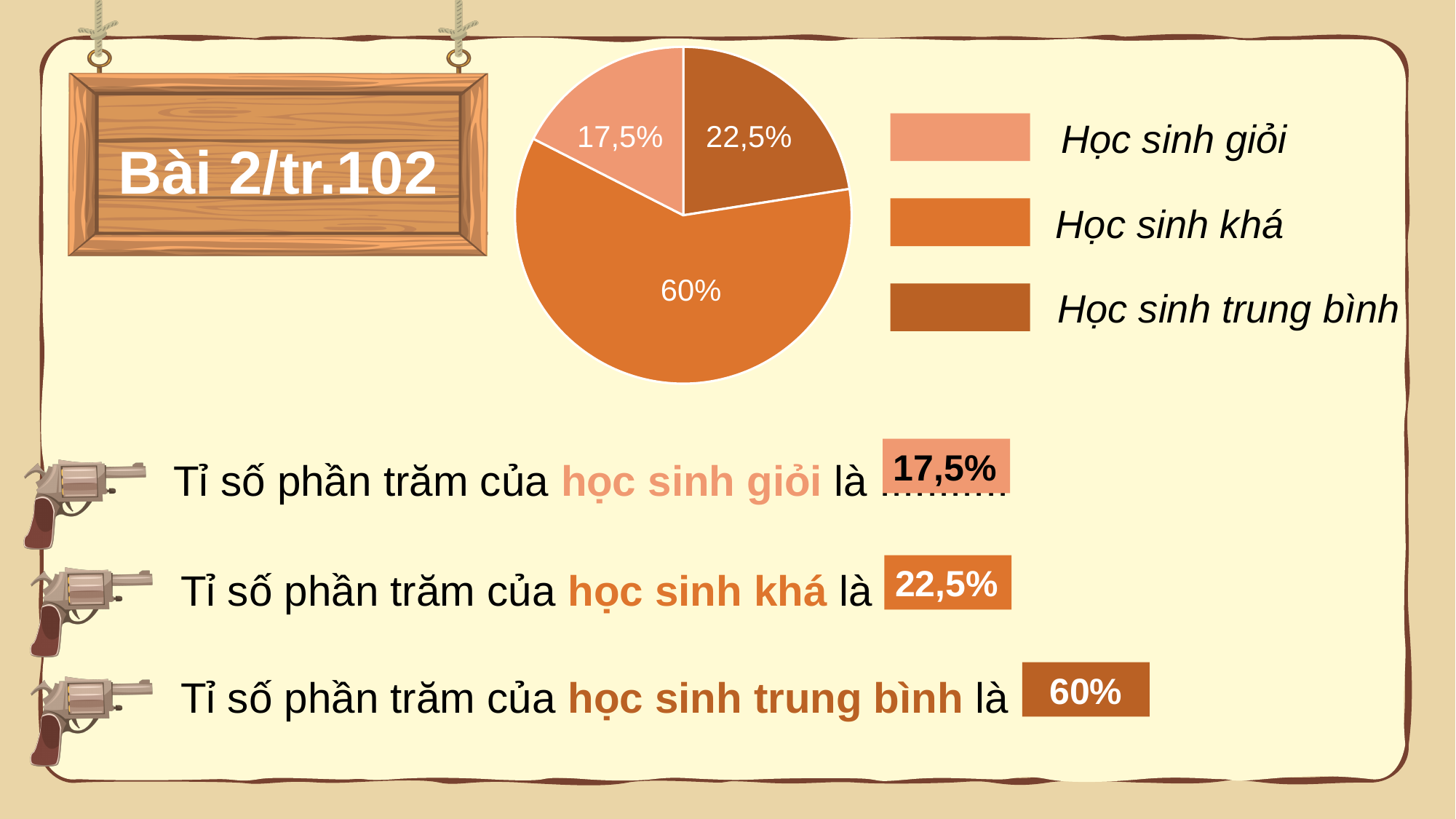
What percentage is shown for Học sinh giỏi in the pie chart? 17,5% What value is printed on the orange slice of the pie chart? 60% Which legend entry is shown with the lightest (salmon) colour in the pie chart? Học sinh giỏi What value is printed on the smallest slice of the pie chart? 17,5% How many entries does the legend of the pie chart list? 3 What is the difference between the 22,5% slice and the 17,5% slice in the pie chart? 5% What kind of chart is shown on the slide? pie chart Which is larger in the pie chart: the slice labelled 22,5% or the slice labelled 17,5%? 22,5% What is the difference between the 60% slice and the 22,5% slice in the pie chart? 37,5% How many slices does the pie chart have? 3 What value is printed on the dark brown slice of the pie chart? 22,5% What value is printed on the largest slice of the pie chart? 60%